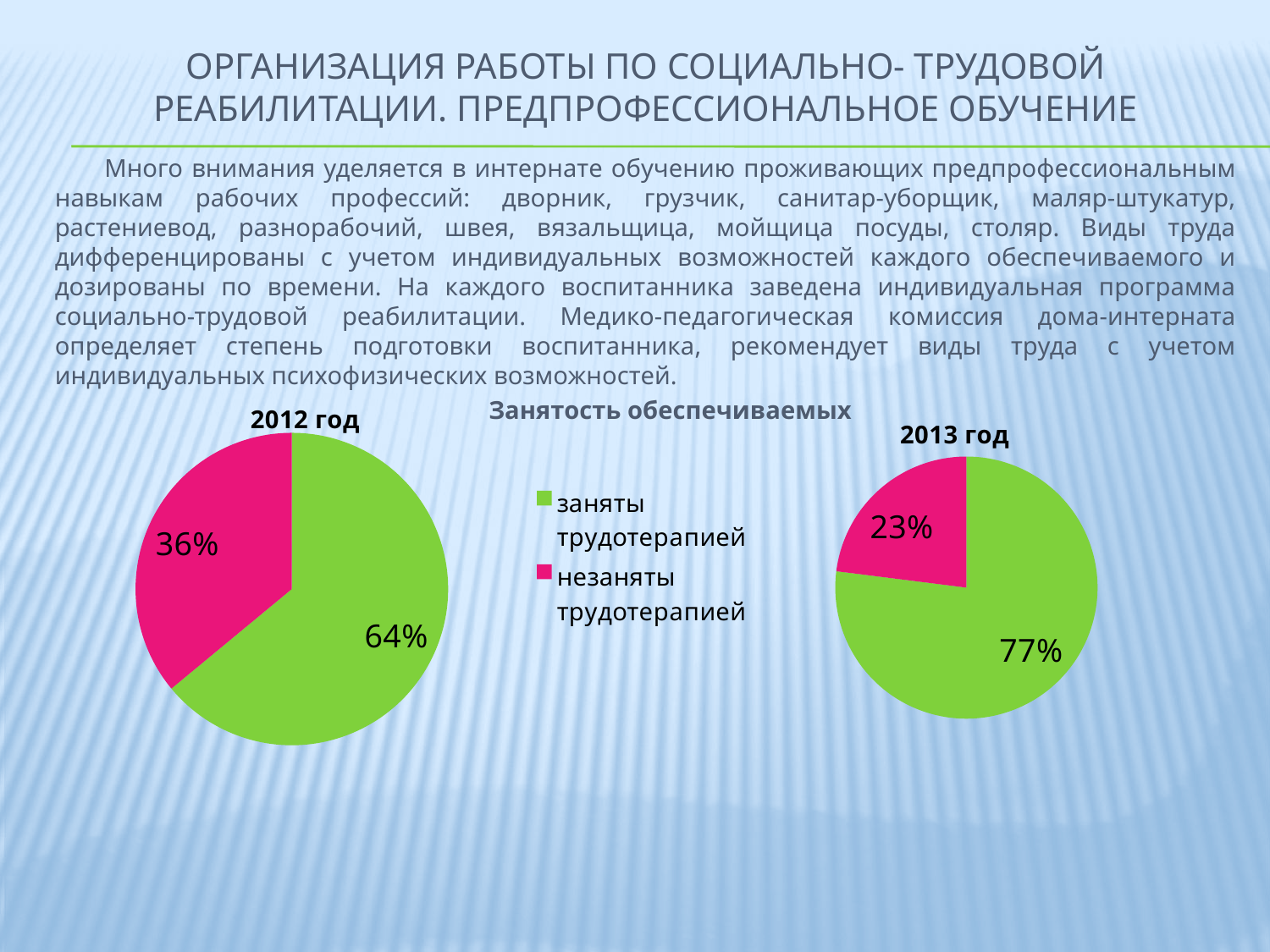
What colour represents "незаняты трудотерапией" in the pie charts? pink In the "2012 год" chart, what share is labelled for "незаняты трудотерапией"? 36% In the "2012 год" chart, what share is labelled for "заняты трудотерапией"? 64% In the "2013 год" chart, what share is labelled for "заняты трудотерапией"? 77% In the "2012 год" chart, what is the difference between the "заняты трудотерапией" and "незаняты трудотерапией" shares? 28% In the "2013 год" chart, which category has the largest slice? заняты трудотерапией Which is larger: the "заняты трудотерапией" share in the "2012 год" chart or in the "2013 год" chart? 2013 год How many slices does the "2013 год" pie chart have? 2 What kind of chart is the "2012 год" chart? pie chart In the "2012 год" chart, which category has the smallest slice? незаняты трудотерапией In the "2013 год" chart, what share is labelled for "незаняты трудотерапией"? 23% How many entries does the legend between the two pie charts list? 2